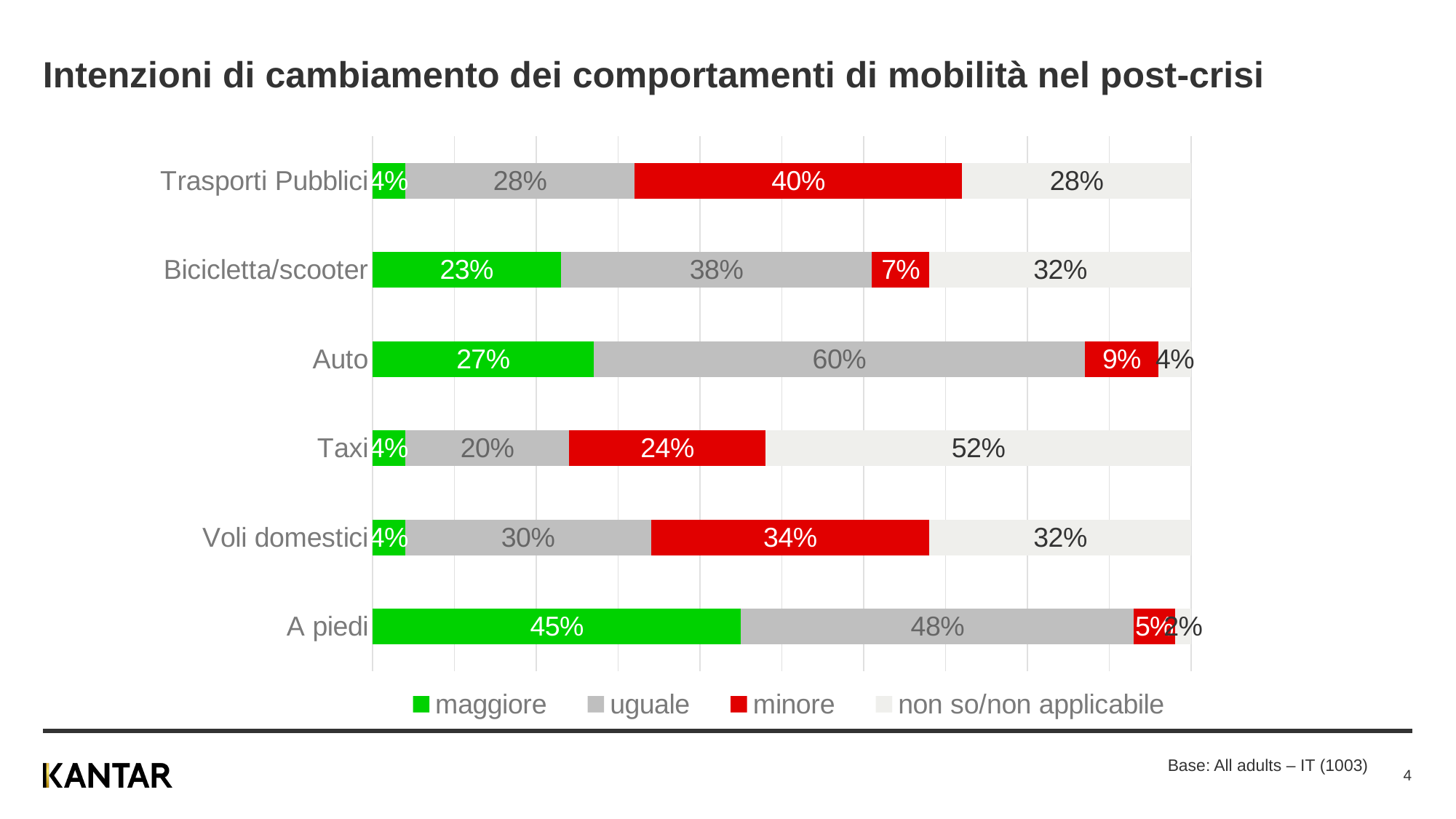
What is the 'maggiore' value for Bicicletta/scooter? 23% What is the 'minore' value for Trasporti Pubblici? 40% What is the 'non so/non applicabile' value for Taxi? 52% Which category has the highest 'maggiore' value? A piedi Which is larger: the 'uguale' value for Bicicletta/scooter or the 'uguale' value for Voli domestici? Bicicletta/scooter How many series does the legend list? 4 What is the 'uguale' value for Auto? 60% How many categories (mobility modes) are shown in the chart? 6 What type of chart is shown on the slide? Stacked bar chart What is the difference between the 'minore' values for Trasporti Pubblici and Voli domestici? 6% Which category has the lowest 'non so/non applicabile' value? A piedi What is the title of the chart? Intenzioni di cambiamento dei comportamenti di mobilità nel post-crisi